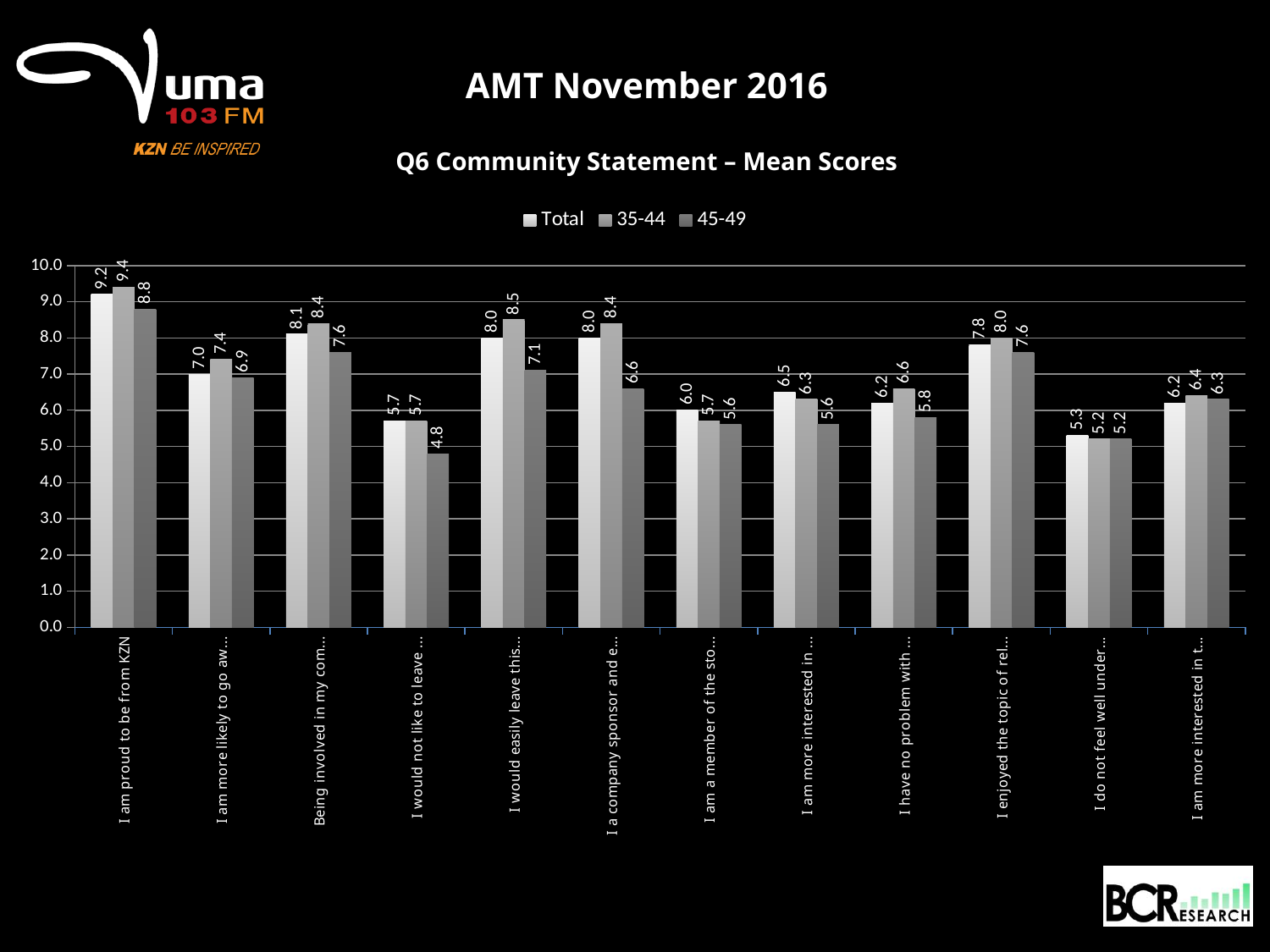
What is the lowest value shown for the 45-49 series? 4.8 What is the Total mean score for "I am proud to be from KZN"? 9.2 Which category has the highest Total mean score? I am proud to be from KZN What are the three series named in the legend? Total, 35-44, 45-49 What is the 45-49 mean score for "I am proud to be from KZN"? 8.8 What kind of chart is shown on the slide? Bar chart How many statement categories are shown on the x axis? 12 For "I am proud to be from KZN", what is the difference between the 35-44 score and the 45-49 score? 0.6 What is the 35-44 mean score for the third category from the left, "Being involved in my com..."? 8.4 Is the Total score for "I am proud to be from KZN" greater or less than 9.0? greater For "I am proud to be from KZN", which is larger: the Total score or the 35-44 score? 35-44 How many series does the legend list? 3